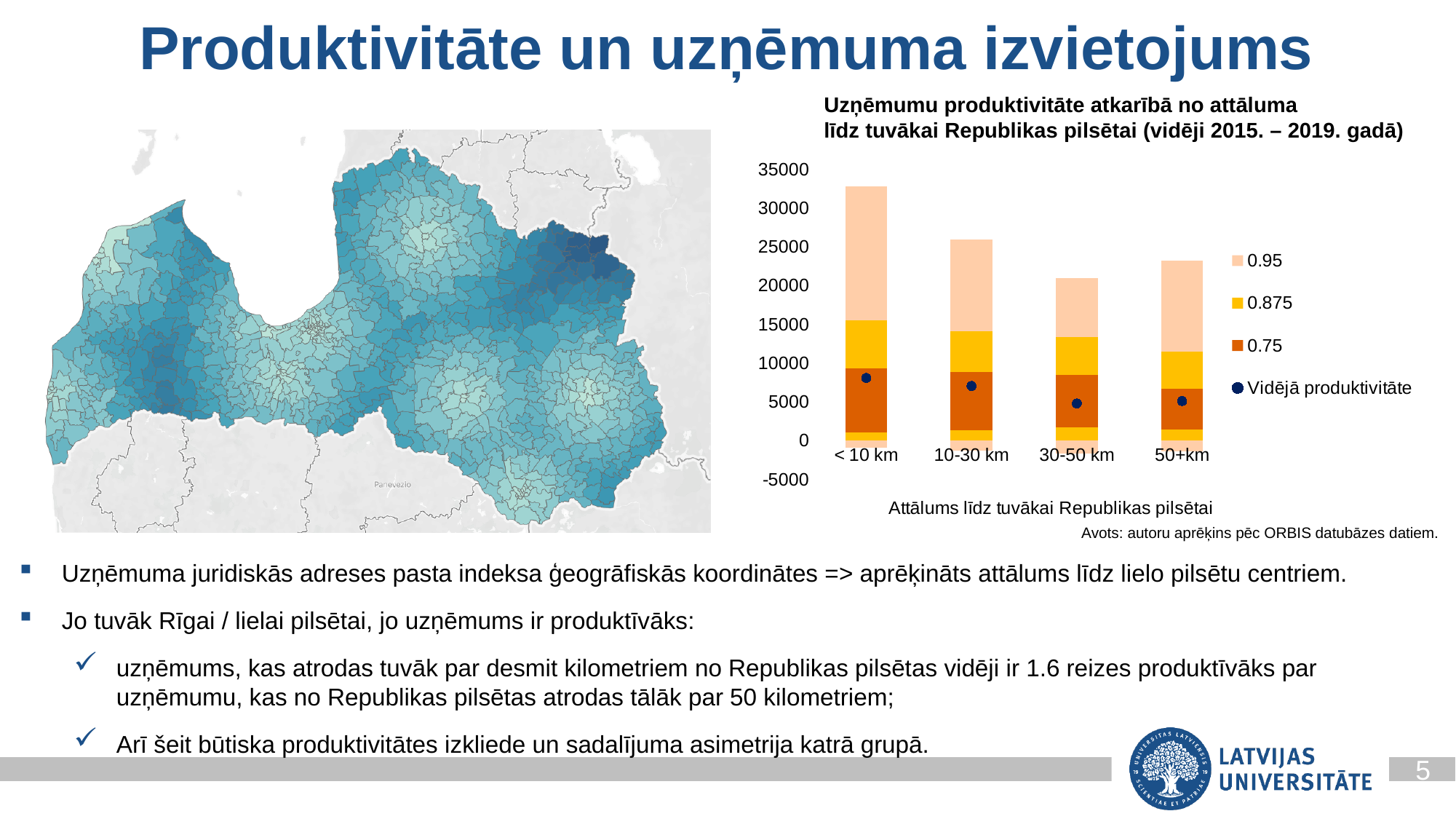
Do the Vidējā produktivitāte points rise or fall from < 10 km to 30-50 km? fall What is the x-axis label of the bar chart? Attālums līdz tuvākai Republikas pilsētai How many distance categories are shown on the x axis of the bar chart? 4 Which stacked bar is taller, < 10 km or 50+km? < 10 km Which legend entry of the bar chart is shown as a dark blue dot rather than a coloured block? Vidējā produktivitāte Is the top of the stacked bar for 10-30 km greater or less than 30000? less Is the top of the stacked bar for 30-50 km greater or less than 25000? less How many entries does the legend of the bar chart list? 4 Is the Vidējā produktivitāte point for < 10 km greater or less than 5000? greater What kind of chart is shown on the right side of the slide? Stacked bar chart with a dot series Which distance category has the tallest stacked bar in the chart? < 10 km